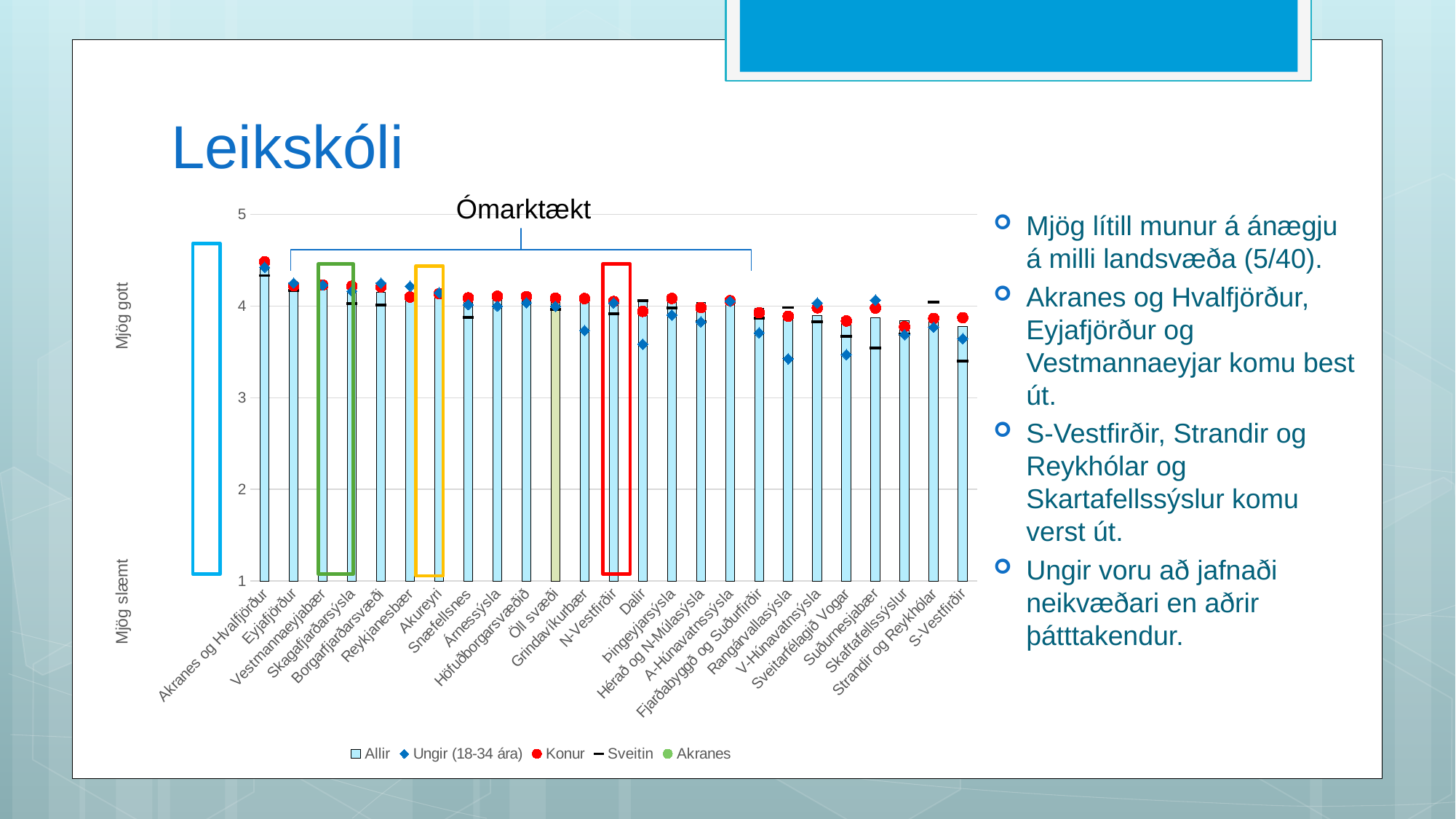
Is the 'Ungir (18-34 ára)' value for Sveitarfélagið Vogar greater or less than 4? less Which region has the highest 'Allir' bar in the chart? Akranes og Hvalfjörður Which region has the lowest 'Allir' bar in the chart? S-Vestfirðir What is the title of the slide containing the chart? Leikskóli What kind of chart is shown on the slide? bar chart Which has the larger 'Allir' bar: Eyjafjörður or Strandir og Reykhólar? Eyjafjörður Do the 'Allir' bar values generally rise or fall from left to right along the x axis? fall Is the 'Allir' value for Akranes og Hvalfjörður greater or less than 4? greater How many regions (categories) are plotted along the x axis of the chart? 25 How many series does the chart legend list? 5 Is the 'Allir' value for S-Vestfirðir greater or less than 4? less What label is written above the bracket spanning the middle group of bars in the chart? Ómarktækt